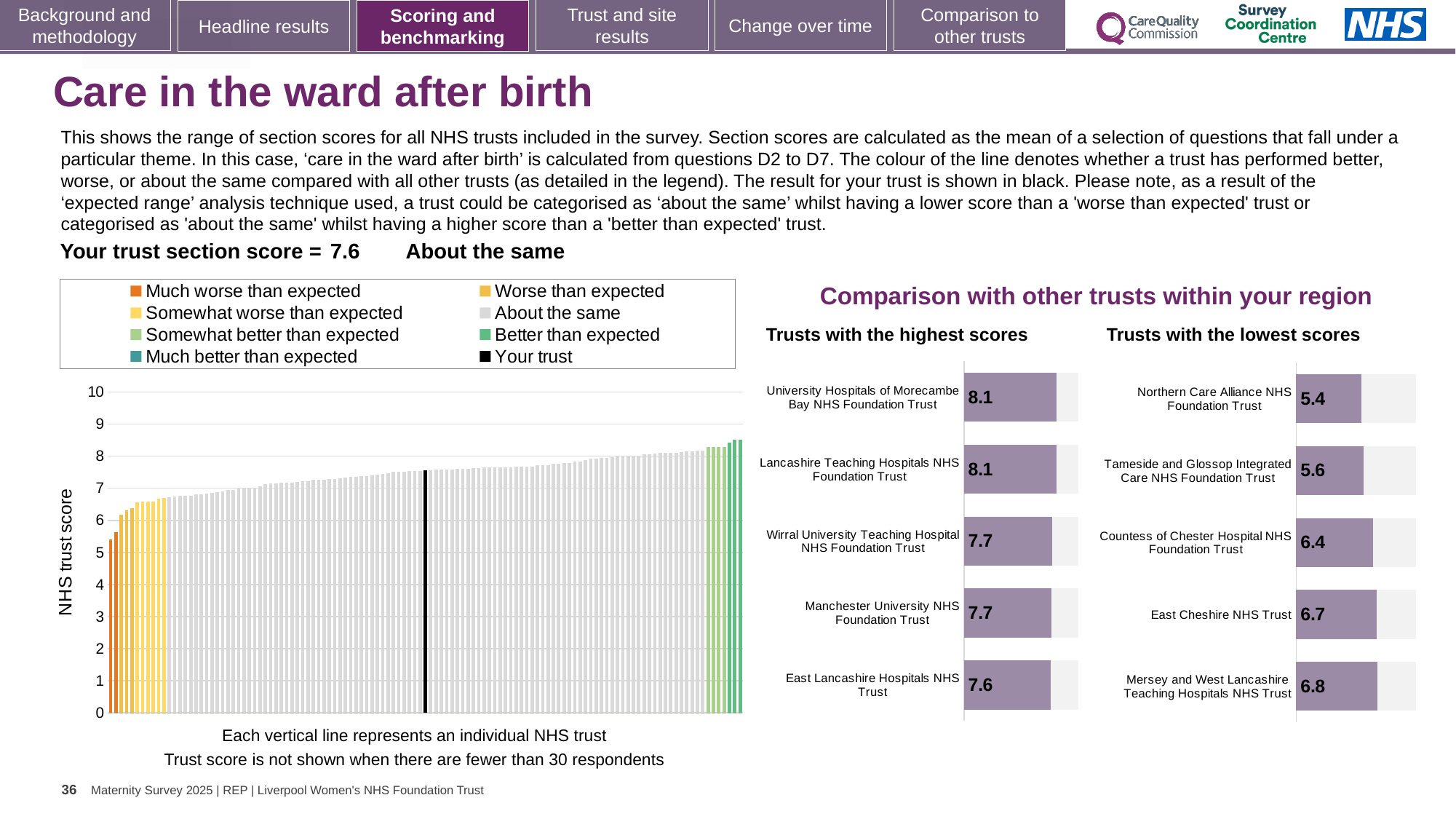
In the 'Trusts with the highest scores' chart, what is the difference between the scores for Lancashire Teaching Hospitals NHS Foundation Trust and East Lancashire Hospitals NHS Trust? 0.5 How many trusts are listed in the 'Trusts with the highest scores' chart? 5 In the 'Trusts with the lowest scores' chart, which trust has the lowest score? Northern Care Alliance NHS Foundation Trust In the 'Trusts with the lowest scores' chart, which has the higher score: Tameside and Glossop Integrated Care NHS Foundation Trust or East Cheshire NHS Trust? East Cheshire NHS Trust In the main chart on the left, do the trust scores rise or fall from left to right? Rise What kind of chart is the main chart on the left showing NHS trust scores? Bar chart How many entries does the legend above the main chart on the left list? 8 In the 'Trusts with the lowest scores' chart, what is the difference between the scores for Mersey and West Lancashire Teaching Hospitals NHS Trust and Northern Care Alliance NHS Foundation Trust? 1.4 In the main chart on the left, what is the section score for your trust (the black line)? 7.6 In the 'Trusts with the highest scores' chart, what is the score for University Hospitals of Morecambe Bay NHS Foundation Trust? 8.1 In the 'Trusts with the highest scores' chart, which trust has the lowest score shown? East Lancashire Hospitals NHS Trust In the 'Trusts with the lowest scores' chart, what is the score for Countess of Chester Hospital NHS Foundation Trust? 6.4